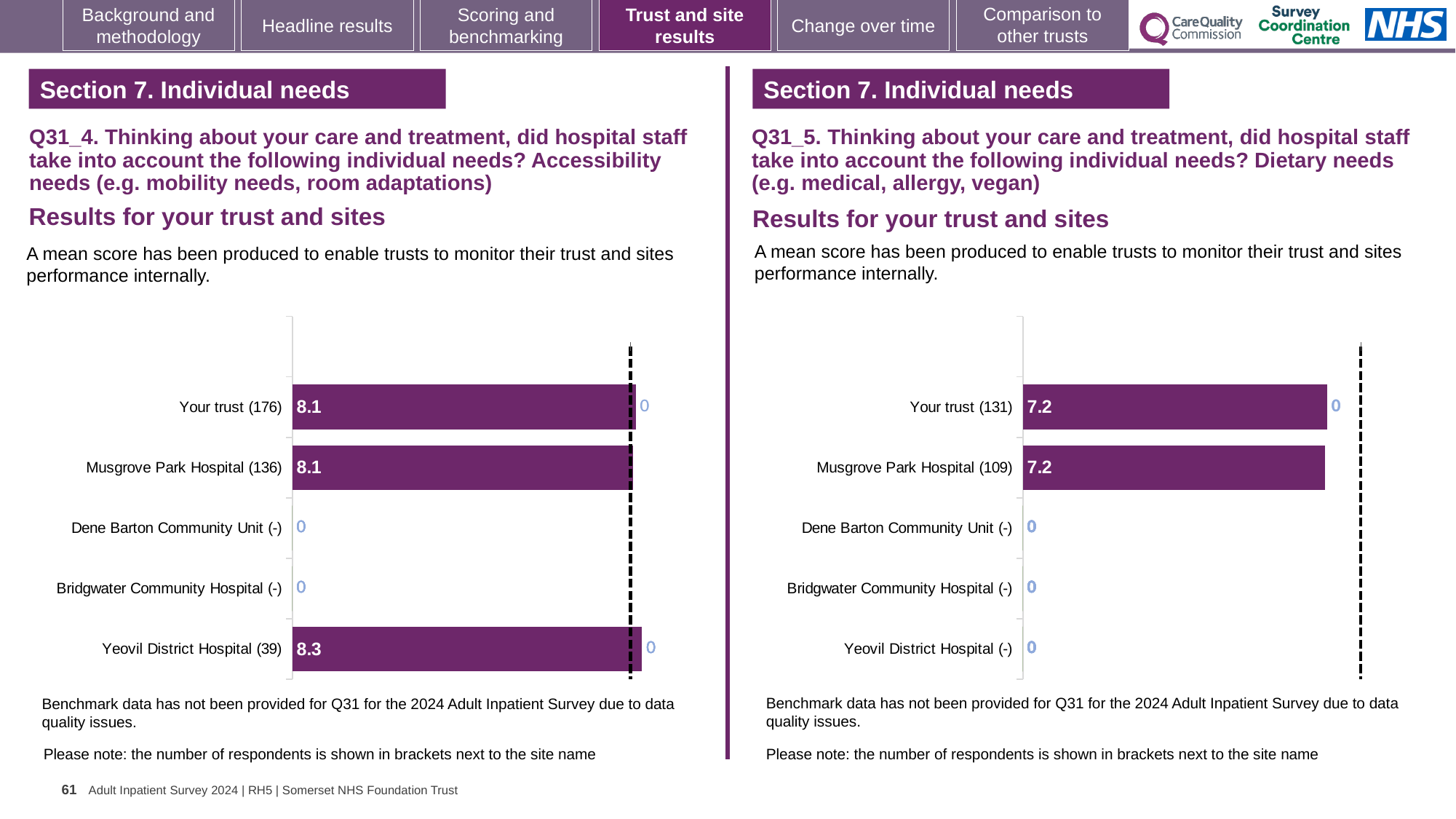
In the Q31_4 Accessibility needs chart on the left, which site has the highest mean score? Yeovil District Hospital (39) In the Q31_5 Dietary needs chart on the right, what is the mean score for Your trust (131)? 7.2 In the Q31_4 Accessibility needs chart on the left, how many respondents are shown in brackets for Yeovil District Hospital? 39 In the Q31_4 Accessibility needs chart on the left, what is the mean score for Musgrove Park Hospital (136)? 8.1 In the Q31_4 Accessibility needs chart on the left, what is the difference between the mean scores for Yeovil District Hospital (39) and Your trust (176)? 0.2 In the Q31_5 Dietary needs chart on the right, how many respondents are shown in brackets for Your trust? 131 In the Q31_4 Accessibility needs chart on the left, which has the larger mean score: Yeovil District Hospital (39) or Musgrove Park Hospital (136)? Yeovil District Hospital (39) In the Q31_5 Dietary needs chart on the right, what is the mean score for Musgrove Park Hospital (109)? 7.2 In the Q31_5 Dietary needs chart on the right, how many sites are listed on the vertical axis? 5 What kind of chart is used in the Q31_4 Accessibility needs chart on the left? Bar chart In the Q31_4 Accessibility needs chart on the left, what is the mean score for Your trust (176)? 8.1 In the Q31_4 Accessibility needs chart on the left, what is the mean score for Yeovil District Hospital (39)? 8.3